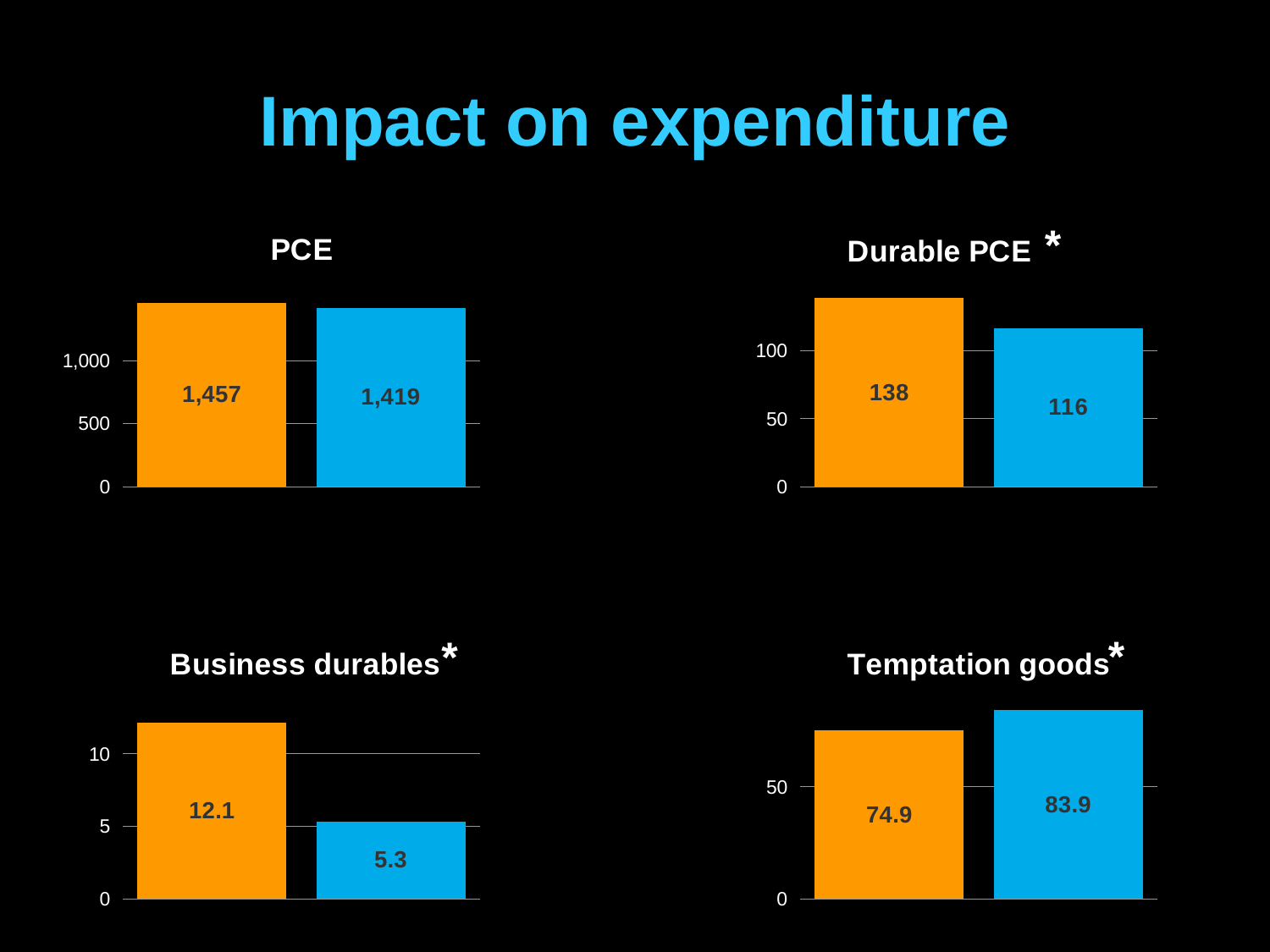
In the Business durables chart, what is the value of the blue bar? 5.3 In the Durable PCE chart, which bar is higher, the orange bar or the blue bar? the orange bar In the Temptation goods chart, which bar is higher, the orange bar or the blue bar? the blue bar In the PCE chart, what is the value of the orange bar? 1,457 In the Durable PCE chart, what is the value of the blue bar? 116 In the Business durables chart, what is the value of the orange bar? 12.1 How many charts are shown on the slide? 4 In the PCE chart, what is the difference between the orange bar and the blue bar? 38 In the PCE chart, what is the value of the blue bar? 1,419 In the Temptation goods chart, what is the difference between the blue bar and the orange bar? 9.0 What type of chart is the Business durables chart? bar chart In the Durable PCE chart, what is the difference between the orange bar and the blue bar? 22